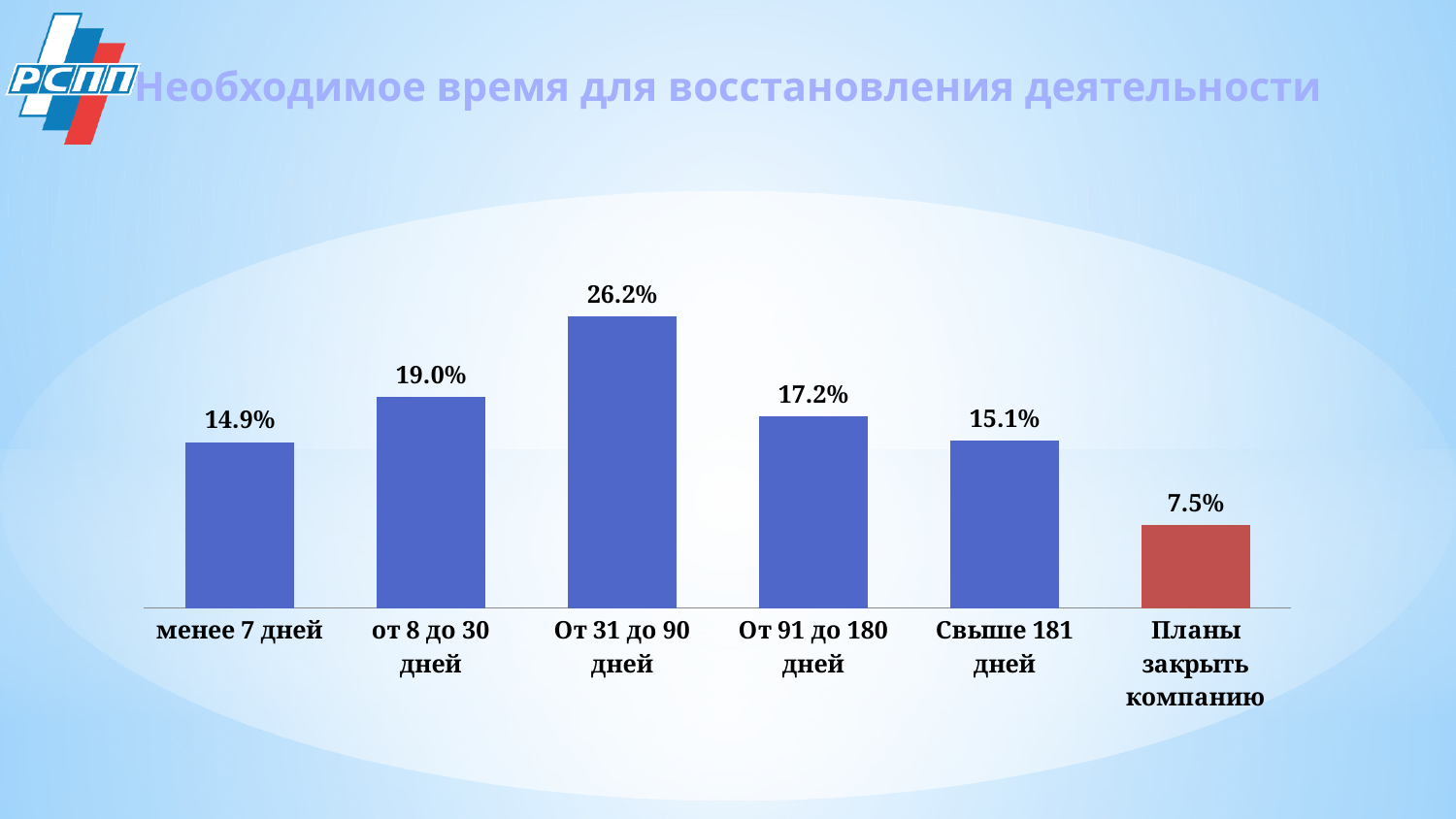
Which category has the highest value? От 31 до 90 дней What is the value for "От 31 до 90 дней"? 26.2% Which category has the lowest value? Планы закрыть компанию How many categories are shown in the chart? 6 What is the difference between the values for "От 31 до 90 дней" and "от 8 до 30 дней"? 7.2% What is the value for "Планы закрыть компанию"? 7.5% What is the value for "менее 7 дней"? 14.9% What is the value for "Свыше 181 дней"? 15.1% Which is larger, the value for "от 8 до 30 дней" or the value for "От 91 до 180 дней"? от 8 до 30 дней What is the title of the chart? Необходимое время для восстановления деятельности What is the difference between the values for "От 91 до 180 дней" and "Планы закрыть компанию"? 9.7% What kind of chart is shown on the slide? Bar chart